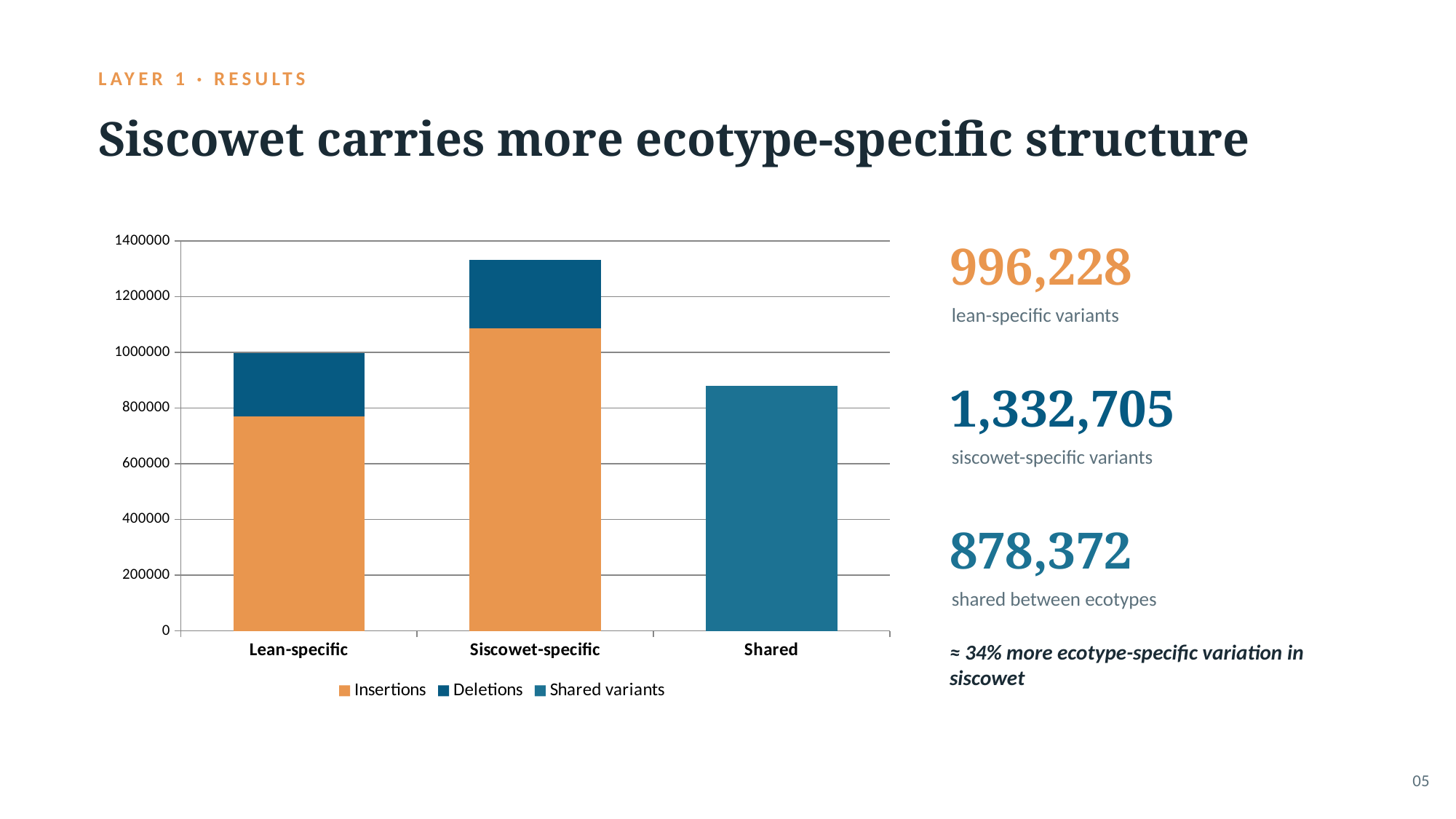
How many categories are shown on the x axis of the chart? 3 What is the total number of siscowet-specific variants? 1,332,705 Is the Insertions segment of the Siscowet-specific bar greater or less than 1000000? greater What kind of chart is shown on the slide? Stacked bar chart Which is larger, the Lean-specific bar or the Shared bar? Lean-specific Which category has the tallest bar? Siscowet-specific What are the three series listed in the chart legend? Insertions, Deletions, Shared variants Which category has the shortest bar? Shared How many series does the chart legend list? 3 What is the total number of lean-specific variants? 996,228 What is the value of the Shared bar? 878,372 What is the difference between the siscowet-specific total and the lean-specific total? 336,477